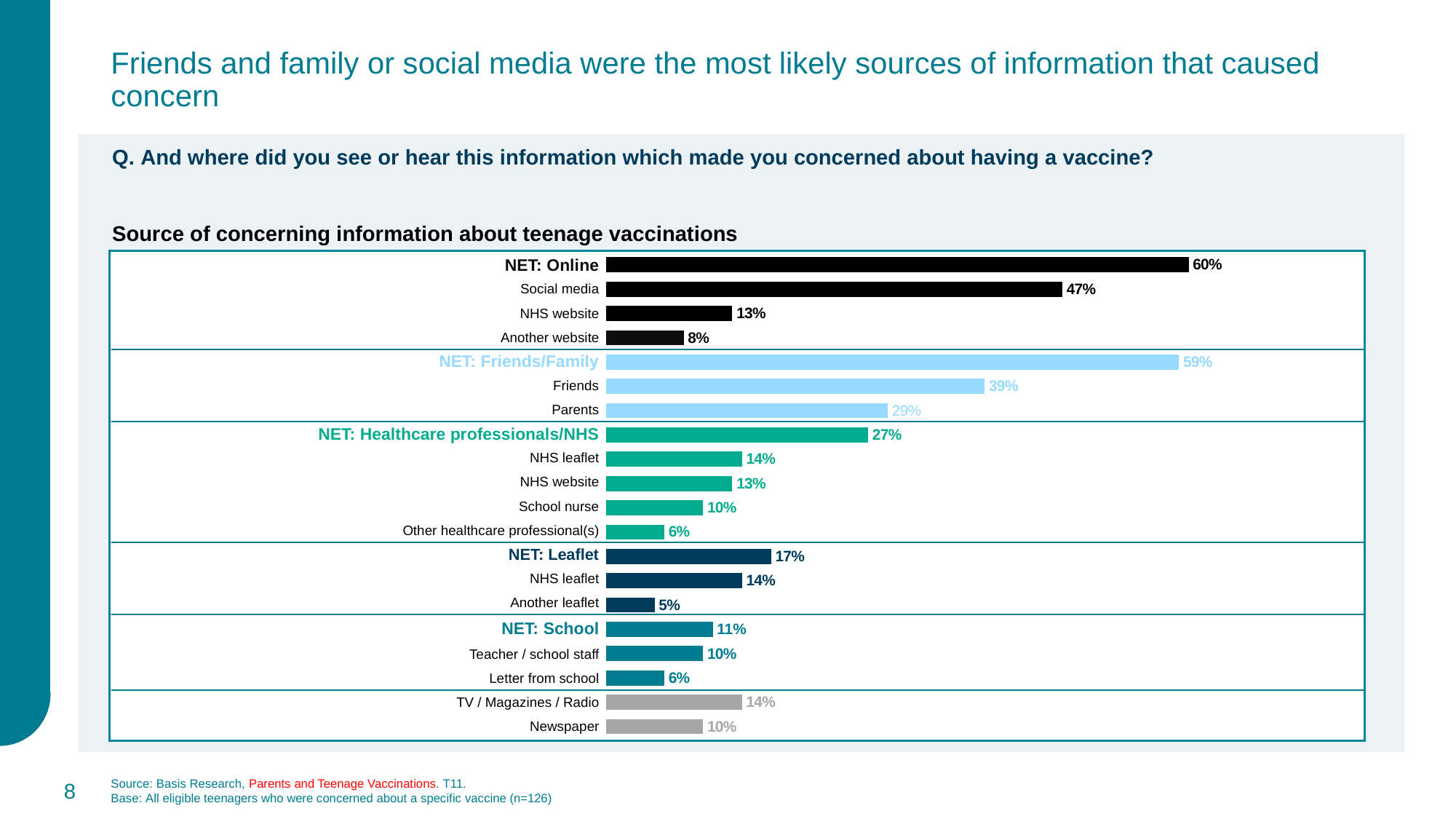
What is the title of the chart? Source of concerning information about teenage vaccinations How much higher is the value for Friends than for Parents? 10 percentage points What is the difference between the values for NET: Online and NET: Friends/Family? 1 percentage point What is the value for Newspaper? 10% Which category has the highest value in the chart? NET: Online What is the value for Parents? 29% How many bars are plotted in the chart? 20 Which is larger, the value for Social media or the value for Friends? Social media Which category has the lowest value in the chart? Another leaflet What percentage is shown for Social media? 47% What type of chart is shown on the slide? Bar chart What percentage is shown for NET: Leaflet? 17%